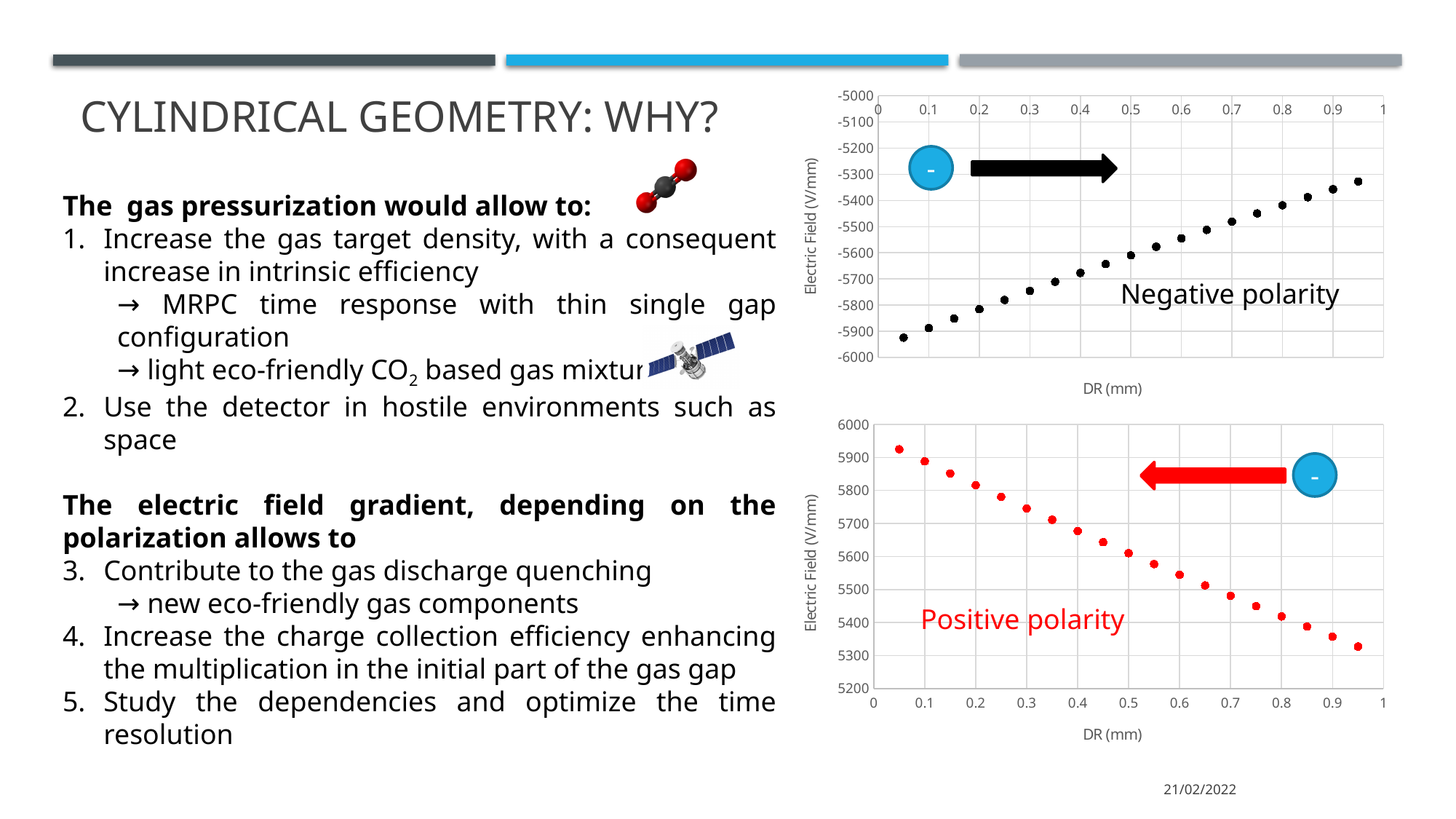
In the top chart (Negative polarity), is the Electric Field value at DR = 0.05 mm greater or less than -5900? less How many data points are plotted in the bottom chart (Positive polarity)? 19 What kind of chart is the bottom chart labelled Positive polarity? scatter chart What kind of chart is the top chart labelled Negative polarity? scatter chart What is the x-axis label of the top chart (Negative polarity)? DR (mm) In the bottom chart (Positive polarity), is the Electric Field value at DR = 0.95 mm greater or less than 5400? less In the top chart (Negative polarity), is the Electric Field value at DR = 0.95 mm greater or less than -5400? greater In the bottom chart (Positive polarity), which has the larger Electric Field value: DR = 0.1 mm or DR = 0.9 mm? DR = 0.1 mm In the top chart (Negative polarity), do the values rise or fall as DR increases along the x axis? rise In the bottom chart (Positive polarity), do the values rise or fall as DR increases along the x axis? fall In the top chart (Negative polarity), which has the larger Electric Field value: DR = 0.1 mm or DR = 0.9 mm? DR = 0.9 mm